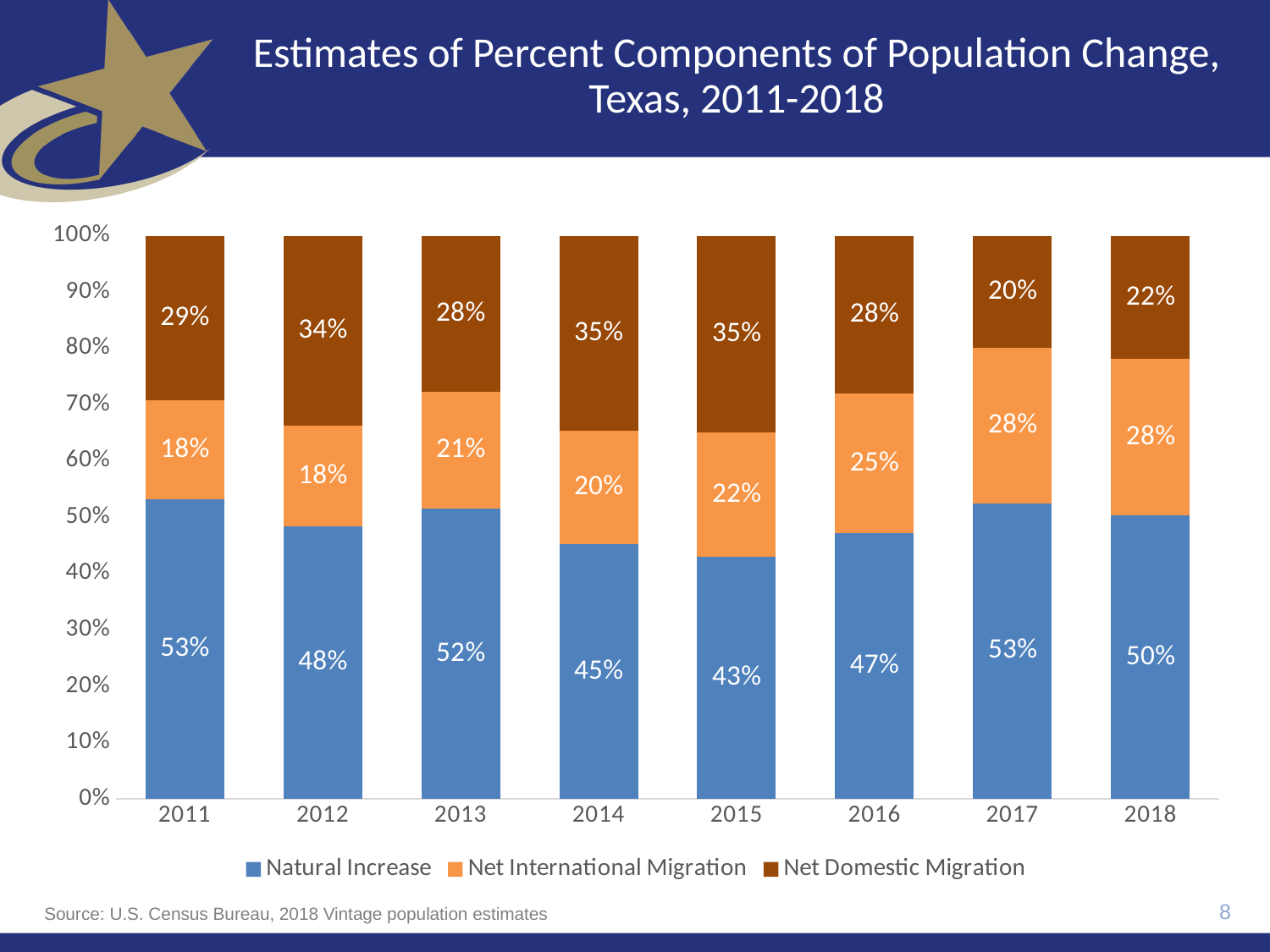
What is the Natural Increase value for 2015? 43% How many years are shown on the x axis? 8 Does the Net International Migration share rise or fall from 2011 to 2018? Rise What is the title of the chart? Estimates of Percent Components of Population Change, Texas, 2011-2018 What is the difference between Net Domestic Migration and Net International Migration in 2015? 13 percentage points What is the Net International Migration value for 2016? 25% In which year is the Natural Increase share lowest? 2015 Which is larger, the Natural Increase share in 2012 or in 2016? 2012 In which year is the Net Domestic Migration share lowest? 2017 What is the Net Domestic Migration value for 2012? 34% What kind of chart is shown on the slide? Stacked bar chart How many series does the legend list? 3